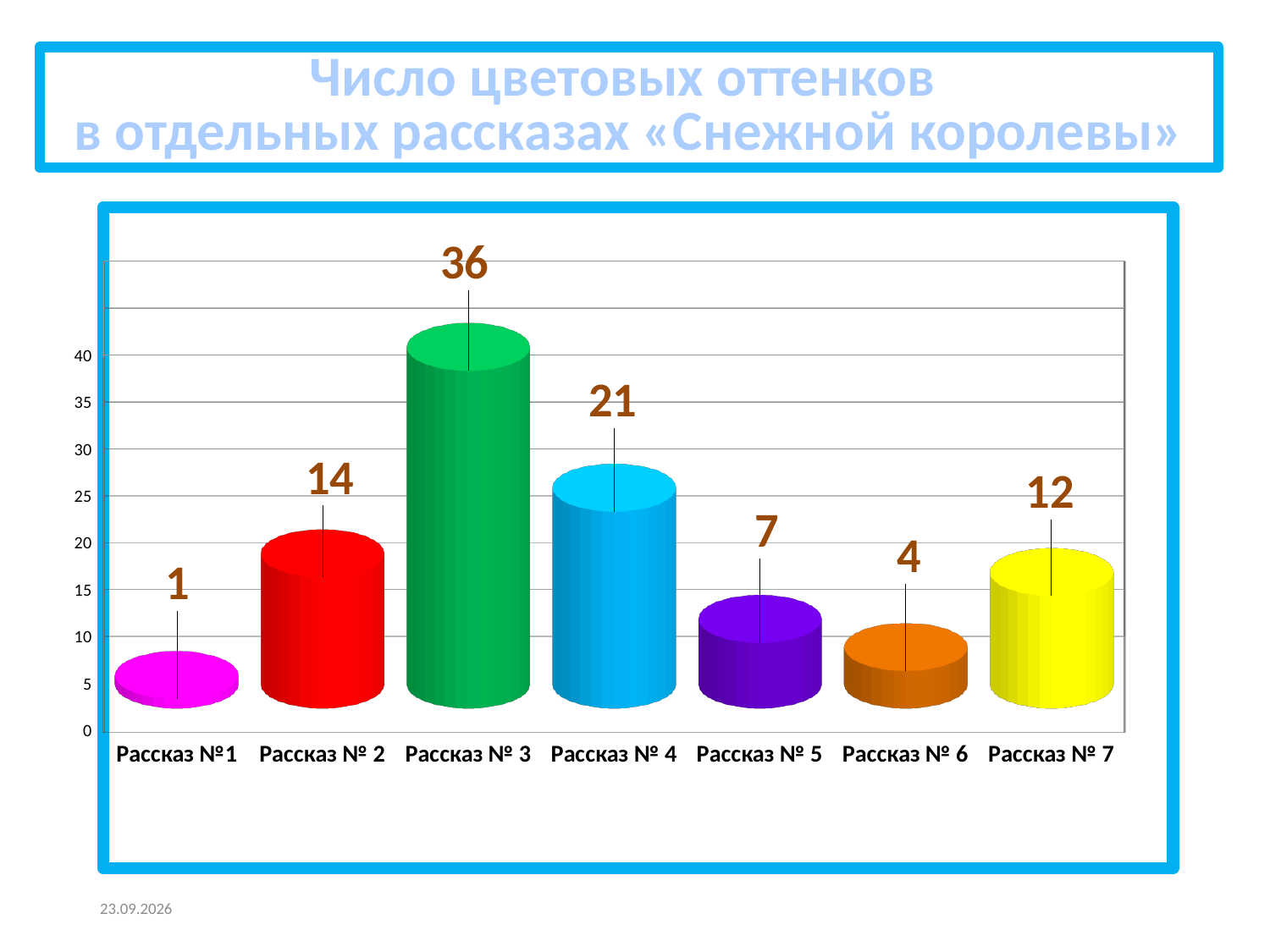
Which category has the highest value? Рассказ № 3 What is the difference between the values for Рассказ № 3 and Рассказ № 4? 15 Which category has the lowest value? Рассказ №1 What is the value for Рассказ № 3? 36 How many categories are shown on the chart? 7 What colour is the bar for Рассказ № 4? Light blue What is the difference between the values for Рассказ № 2 and Рассказ № 6? 10 Which is larger, the value for Рассказ № 2 or the value for Рассказ № 7? Рассказ № 2 What kind of chart is shown on the slide? Bar chart What is the title of the chart on the slide? Число цветовых оттенков в отдельных рассказах «Снежной королевы» What is the value for Рассказ № 5? 7 What is the value for Рассказ № 7? 12